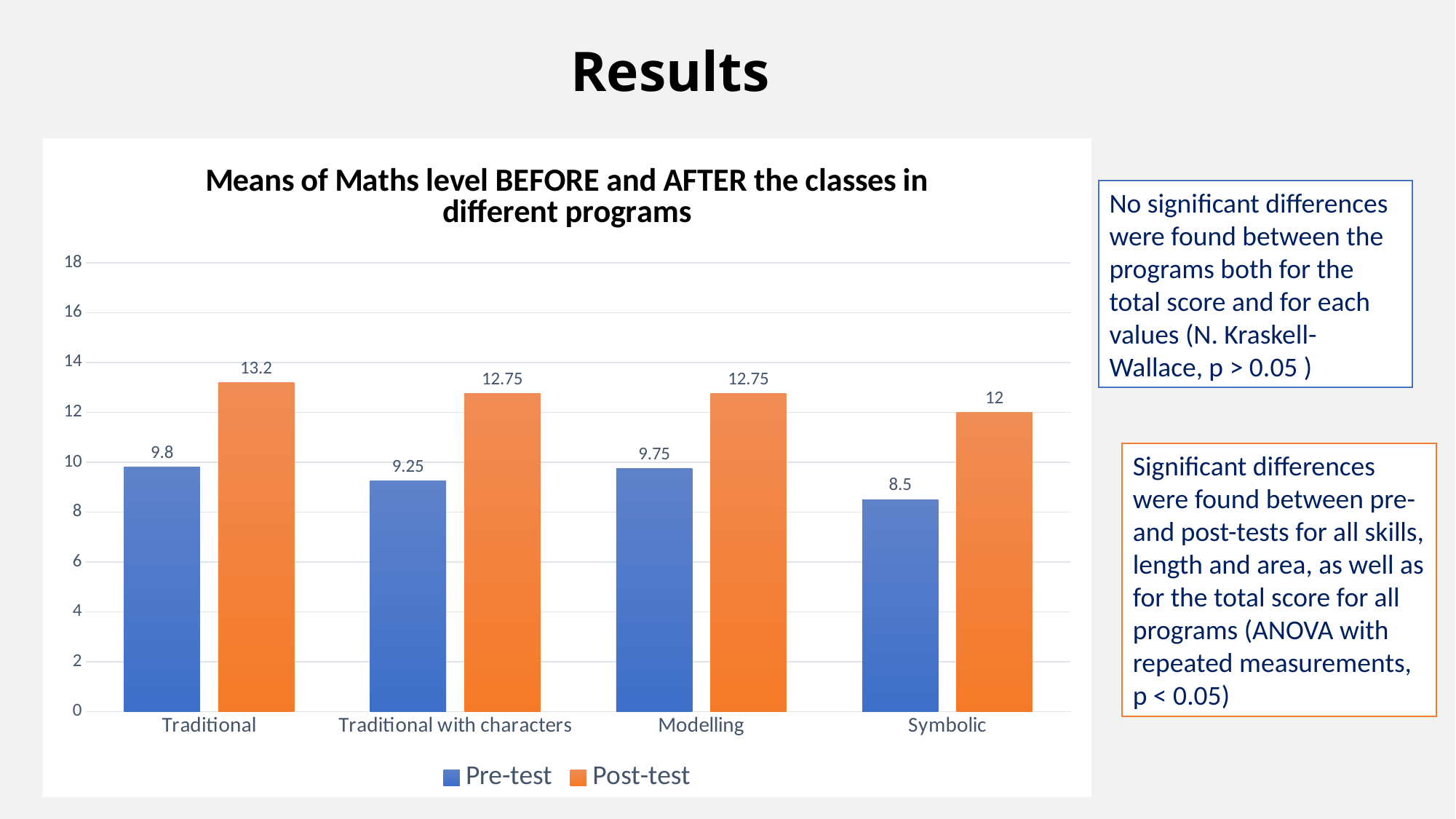
What is the Post-test value for Symbolic? 12 Which program has the lowest Pre-test value? Symbolic How many series does the legend list? 2 How many programs (categories) are shown on the x axis? 4 Which is larger, the Pre-test value for Traditional with characters or the Pre-test value for Modelling? Modelling What kind of chart is shown on the slide? Bar chart What is the difference between the Post-test and Pre-test values for Symbolic? 3.5 What is the difference between the Post-test and Pre-test values for Traditional? 3.4 Which program has the highest Post-test value? Traditional What is the Pre-test value for Traditional? 9.8 What is the Post-test value for Modelling? 12.75 What is the title of the chart? Means of Maths level BEFORE and AFTER the classes in different programs